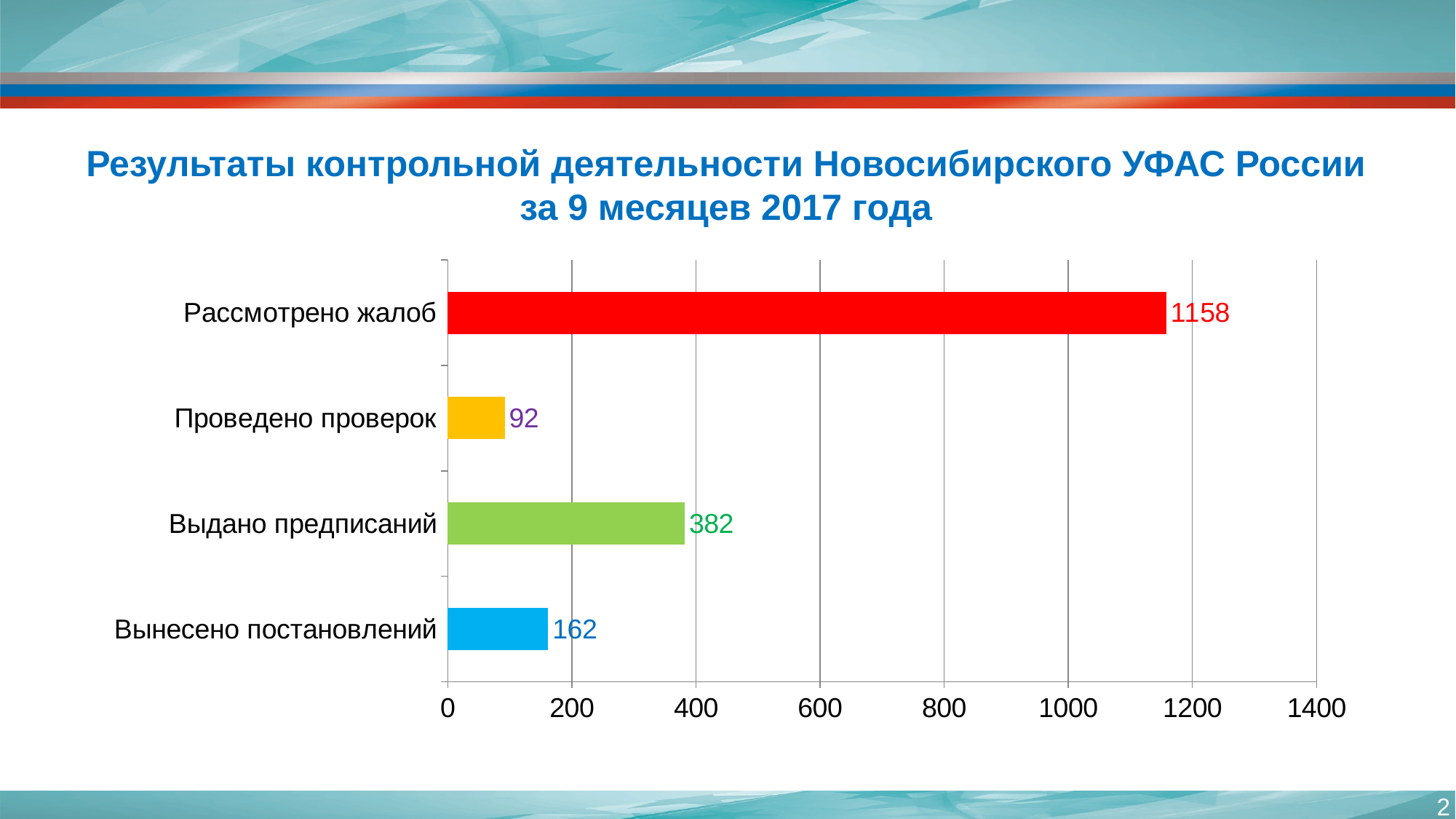
What kind of chart is shown on the slide? bar chart What is the value for Выдано предписаний? 382 What is the difference between Вынесено постановлений and Проведено проверок? 70 What is the difference between Рассмотрено жалоб and Выдано предписаний? 776 What is the value for Проведено проверок? 92 How many categories are shown in the chart? 4 Is the value for Рассмотрено жалоб greater or less than 1000? greater Which is larger, Выдано предписаний or Вынесено постановлений? Выдано предписаний What is the value for Рассмотрено жалоб? 1158 Which category has the lowest value? Проведено проверок Which category has the highest value? Рассмотрено жалоб What is the value for Вынесено постановлений? 162